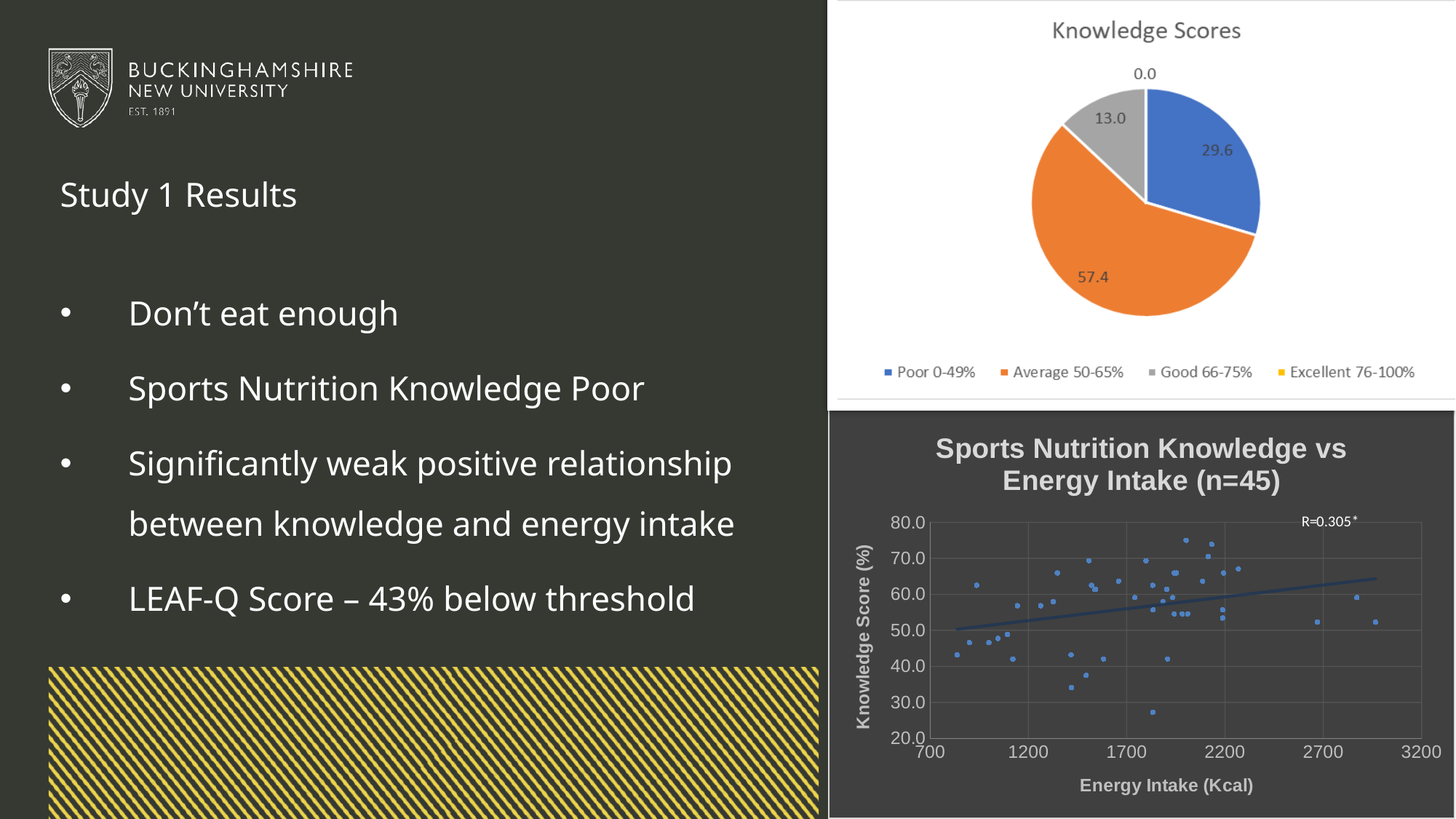
In the Knowledge Scores pie chart, which is larger: the Poor 0-49% slice or the Good 66-75% slice? Poor 0-49% In the Knowledge Scores pie chart, what value is shown for the Average 50-65% slice? 57.4 In the Knowledge Scores pie chart, what value is shown for the Good 66-75% slice? 13.0 In the Knowledge Scores pie chart, what value is shown for the Poor 0-49% slice? 29.6 How many categories does the legend of the Knowledge Scores pie chart list? 4 In the Knowledge Scores pie chart, which category has the largest slice? Average 50-65% In the Knowledge Scores pie chart, what is the difference between the Average 50-65% value and the Poor 0-49% value? 27.8 In the Knowledge Scores pie chart, what value is shown for the Excellent 76-100% category? 0.0 In the Sports Nutrition Knowledge vs Energy Intake chart, does the trend line rise or fall as energy intake increases? Rises What kind of chart is the Sports Nutrition Knowledge vs Energy Intake chart? Scatter chart What R value is printed on the Sports Nutrition Knowledge vs Energy Intake chart? R=0.305* In the Knowledge Scores pie chart, which category has the smallest value? Excellent 76-100%